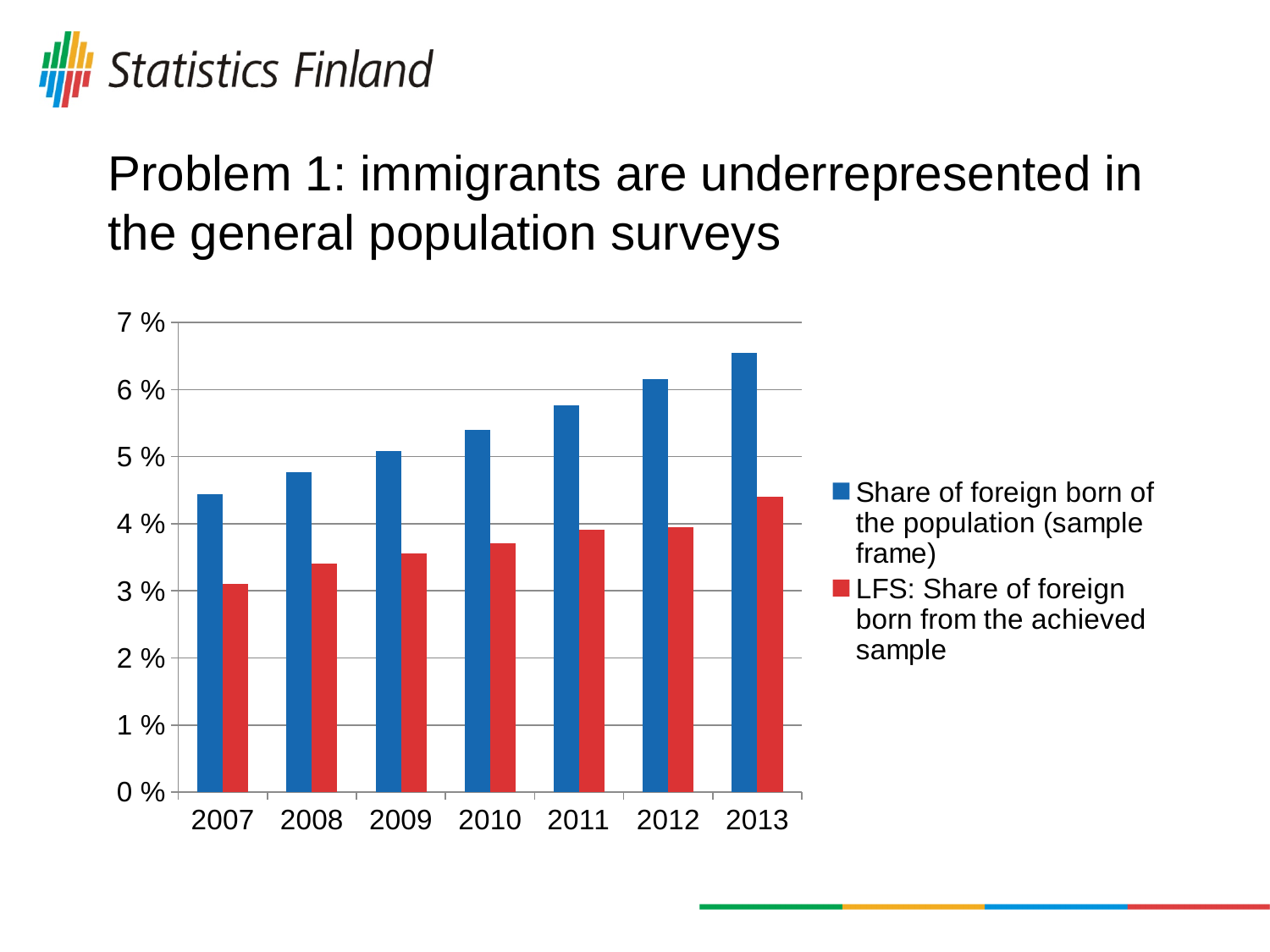
Which year has the highest value for 'Share of foreign born of the population (sample frame)'? 2013 Is the 2013 value for 'LFS: Share of foreign born from the achieved sample' greater or less than 4 %? greater Is the 2007 value for 'Share of foreign born of the population (sample frame)' greater or less than 5 %? less What colour are the bars for 'LFS: Share of foreign born from the achieved sample'? red How many years are shown on the x axis? 7 Do the values for 'Share of foreign born of the population (sample frame)' rise or fall from 2007 to 2013? rise In 2010, which series has the larger value: 'Share of foreign born of the population (sample frame)' or 'LFS: Share of foreign born from the achieved sample'? Share of foreign born of the population (sample frame) Is the 2008 value for 'LFS: Share of foreign born from the achieved sample' greater or less than 4 %? less What kind of chart is shown on the slide? bar chart Which year has the lowest value for 'LFS: Share of foreign born from the achieved sample'? 2007 How many series does the legend list? 2